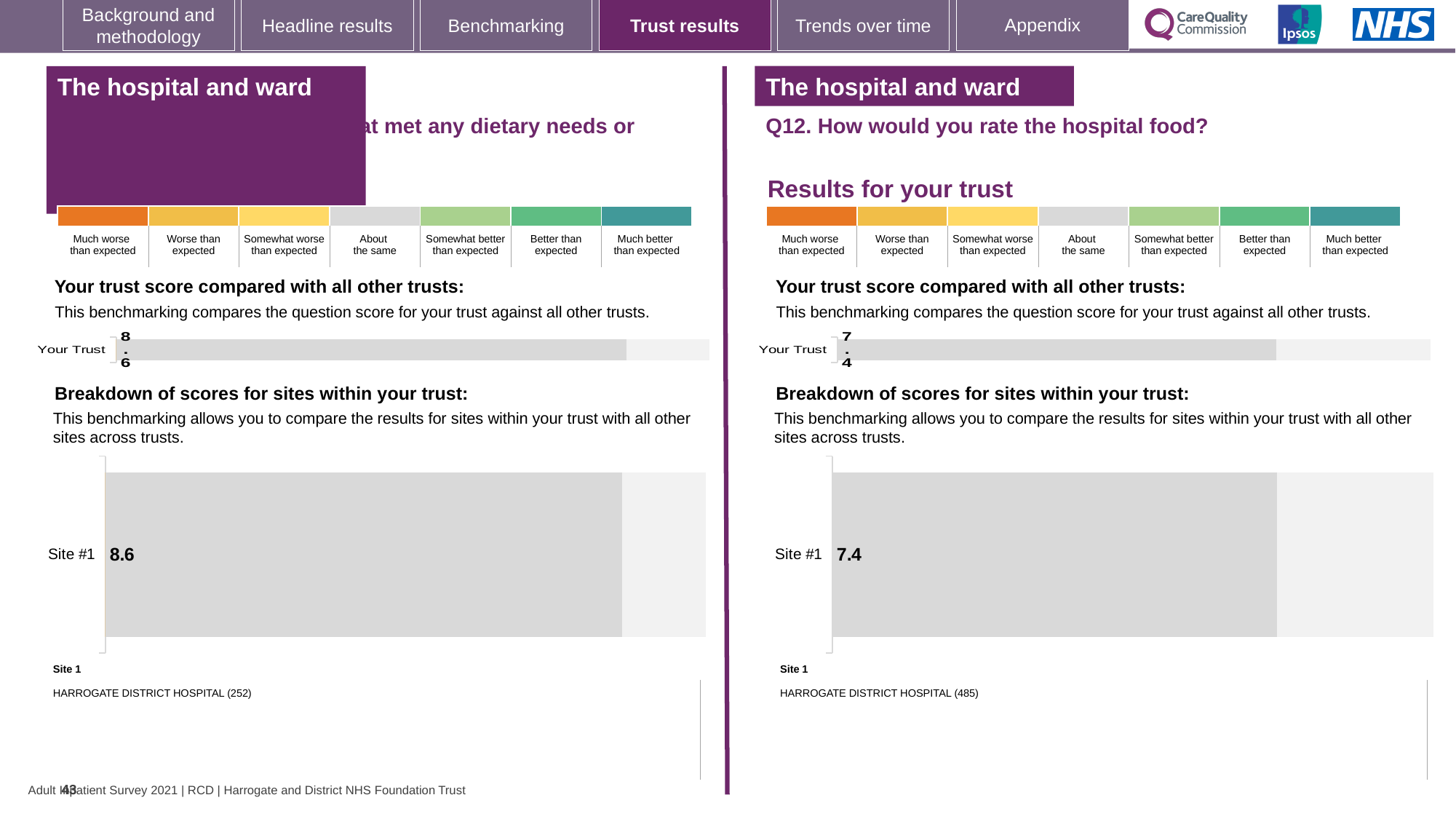
On the left panel, what is the score shown for Your Trust? 8.6 What is the difference between the Site #1 score on the left panel and the Site #1 score on the right panel? 1.2 How many sites are shown in the breakdown of scores on the right panel? 1 On the left panel, which site name is listed as Site 1? HARROGATE DISTRICT HOSPITAL (252) Which is larger: the Your Trust score on the left panel or the Your Trust score on the right panel (Q12)? Left panel How many sites are shown in the breakdown of scores on the left panel? 1 On the right panel (Q12. How would you rate the hospital food?), what is the score shown for Your Trust? 7.4 On the right panel, which site name is listed as Site 1? HARROGATE DISTRICT HOSPITAL (485) What kind of chart is used to show the Site #1 score on the right panel? Bar chart On the left panel's breakdown of scores for sites, what is the score for Site #1? 8.6 On the right panel's breakdown of scores for sites, what is the score for Site #1? 7.4